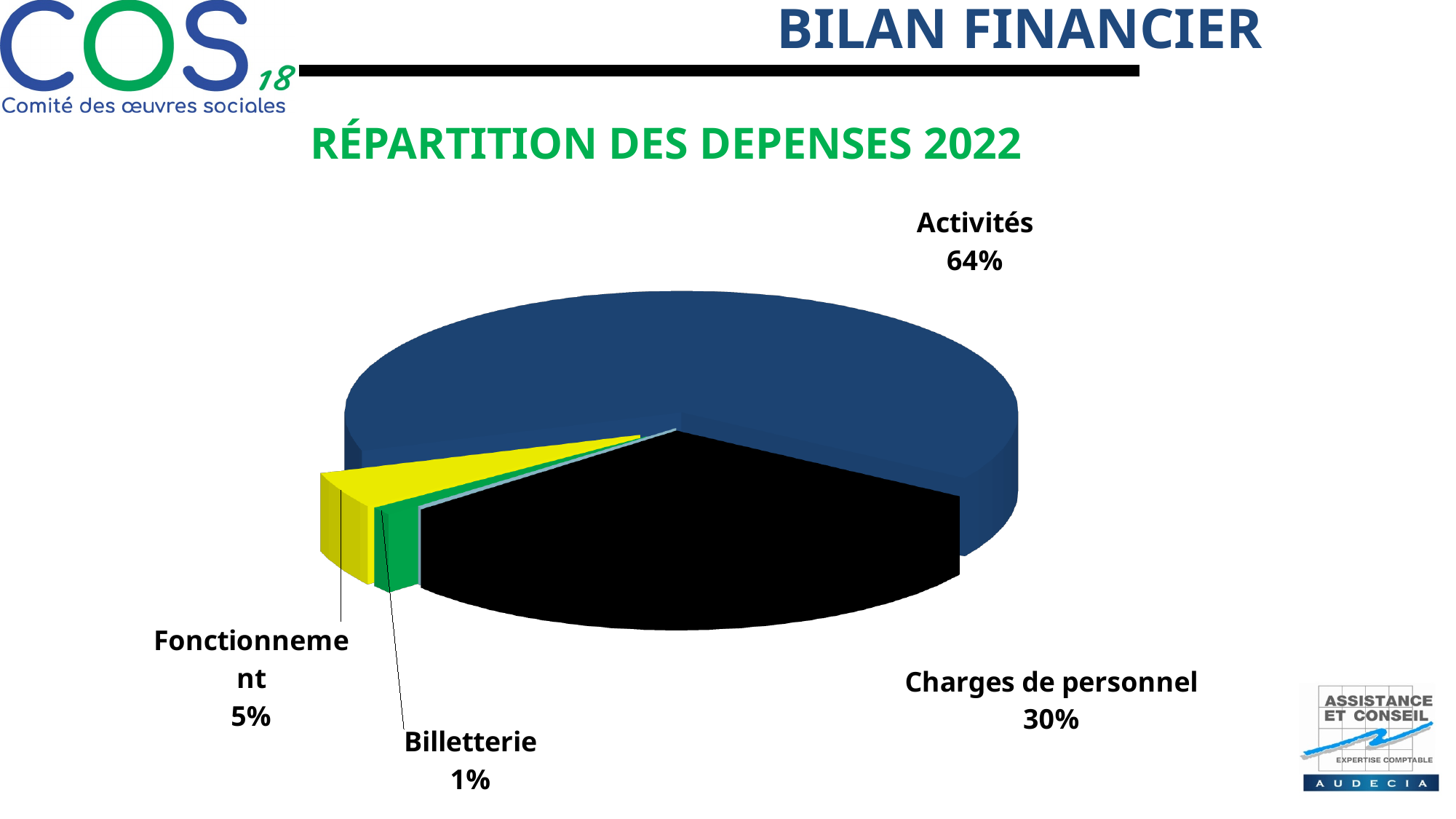
What is the difference in percentage points between Activités and Charges de personnel? 34 Which category has the largest share of the pie? Activités Which category has the smallest share of the pie? Billetterie What is the difference in percentage points between Fonctionnement and Billetterie? 4 What share of the pie does Billetterie represent? 1% How many categories are shown in the pie chart? 4 What is the title of the chart? RÉPARTITION DES DEPENSES 2022 What share of the pie does Activités represent? 64% Which is larger, Charges de personnel or Fonctionnement? Charges de personnel What kind of chart is shown on the slide? Pie chart What share of the pie does Charges de personnel represent? 30% What share of the pie does Fonctionnement represent? 5%